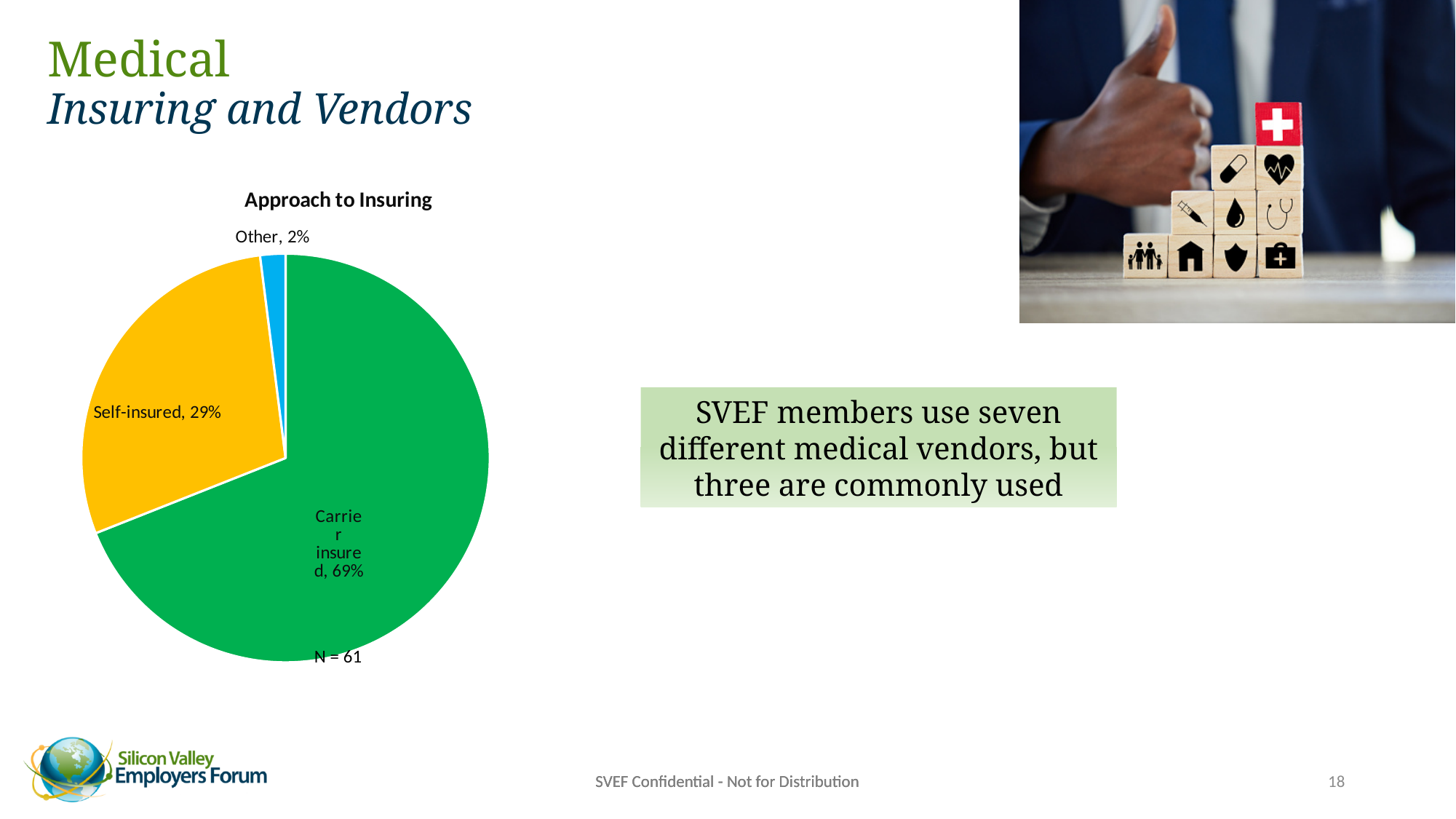
What share of the pie is Carrier insured? 69% What is the title of the pie chart? Approach to Insuring What is the difference in percentage points between Carrier insured and Self-insured? 40 What share of the pie is Self-insured? 29% How many categories does the pie chart show? 3 Which category has the smallest slice of the pie? Other Which is larger, Self-insured or Other? Self-insured What kind of chart is shown on the slide? pie chart Which category has the largest slice of the pie? Carrier insured What share of the pie is Other? 2% What is the sample size (N) shown on the chart? N = 61 What colour is the Self-insured slice? yellow